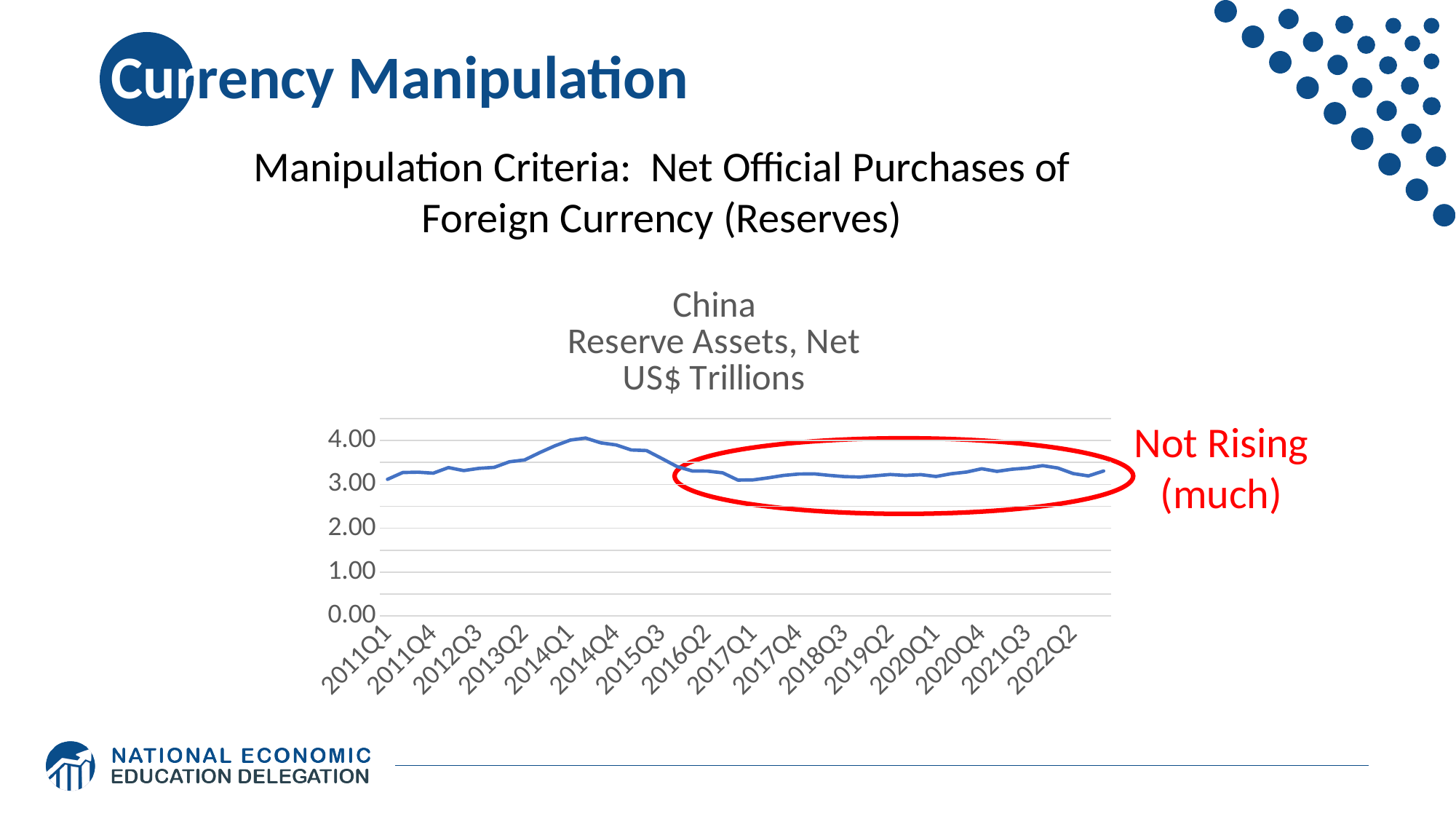
How many quarter labels are shown along the x axis? 16 Is the value for 2014Q1 greater or less than 3.00? greater Does the line rise or fall between 2011Q1 and 2014Q1? rise Does the line rise or fall between 2014Q1 and 2016Q2? fall Is the value for 2011Q1 greater or less than 2.00? greater What does the red annotation next to the circled part of the chart say? Not Rising (much) Which is larger, the value for 2014Q1 or the value for 2017Q1? 2014Q1 Is the value for 2017Q1 greater or less than 4.00? less What is the title of the chart? China Reserve Assets, Net US$ Trillions What kind of chart is shown on the slide? line chart Around which labeled quarter does the line reach its highest point? 2014Q1